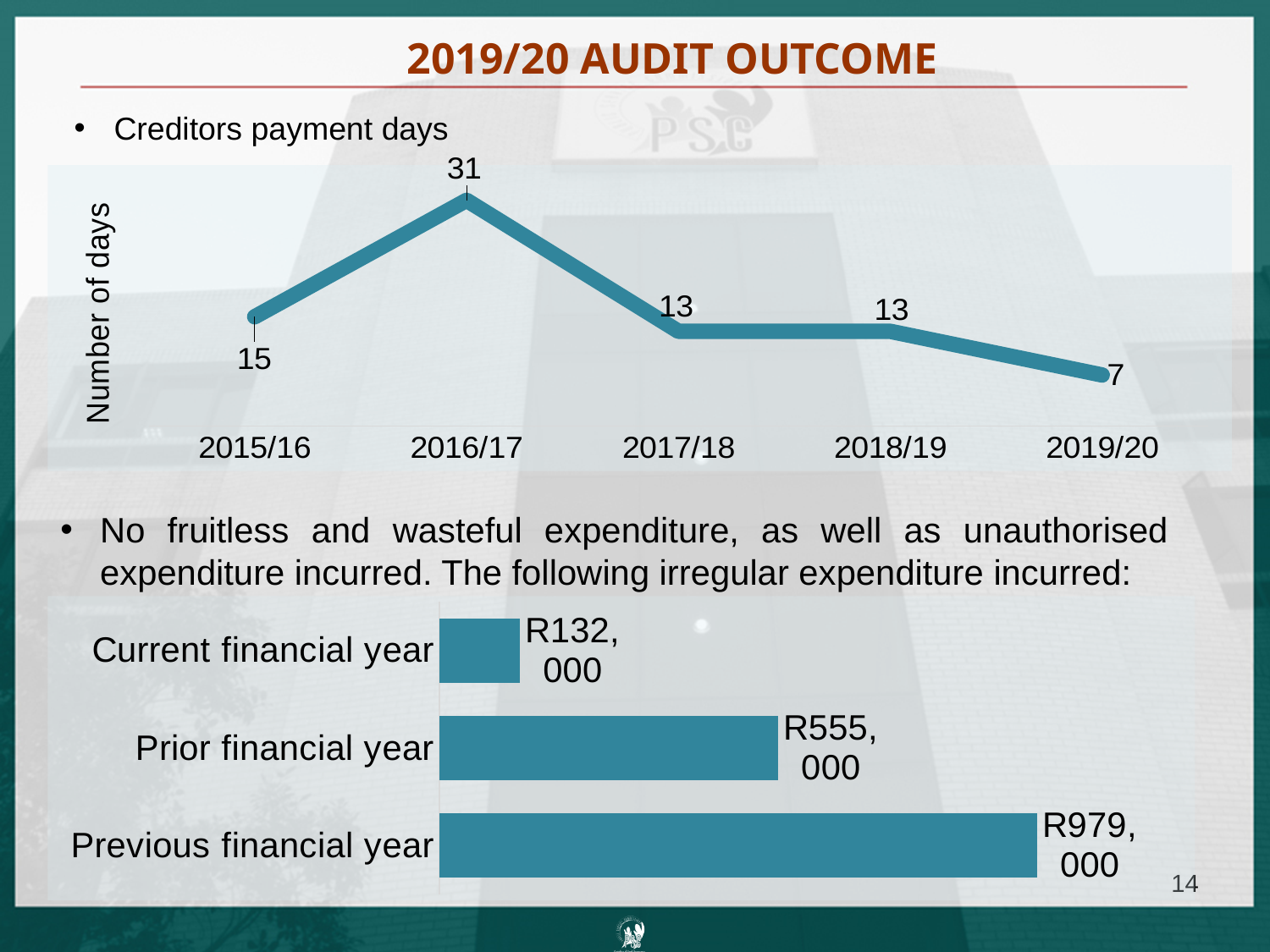
What kind of chart is the irregular expenditure chart at the bottom of the slide? bar chart In the creditors payment days line chart, what was the number of days in 2016/17? 31 In the creditors payment days line chart, do the values rise or fall from 2017/18 to 2019/20? fall In the irregular expenditure bar chart at the bottom, which category has the largest value? Previous financial year In the creditors payment days line chart, how many years are plotted? 5 In the irregular expenditure bar chart at the bottom, what is the difference between the Previous financial year and the Current financial year? R847,000 In the creditors payment days line chart, what was the number of days in 2019/20? 7 In the creditors payment days line chart, what is the difference in days between 2016/17 and 2015/16? 16 In the creditors payment days line chart, what is the label on the vertical axis? Number of days In the irregular expenditure bar chart at the bottom, what is the value for the Prior financial year? R555,000 In the creditors payment days line chart, which year had the highest number of days? 2016/17 In the creditors payment days line chart, which year had the lowest number of days? 2019/20